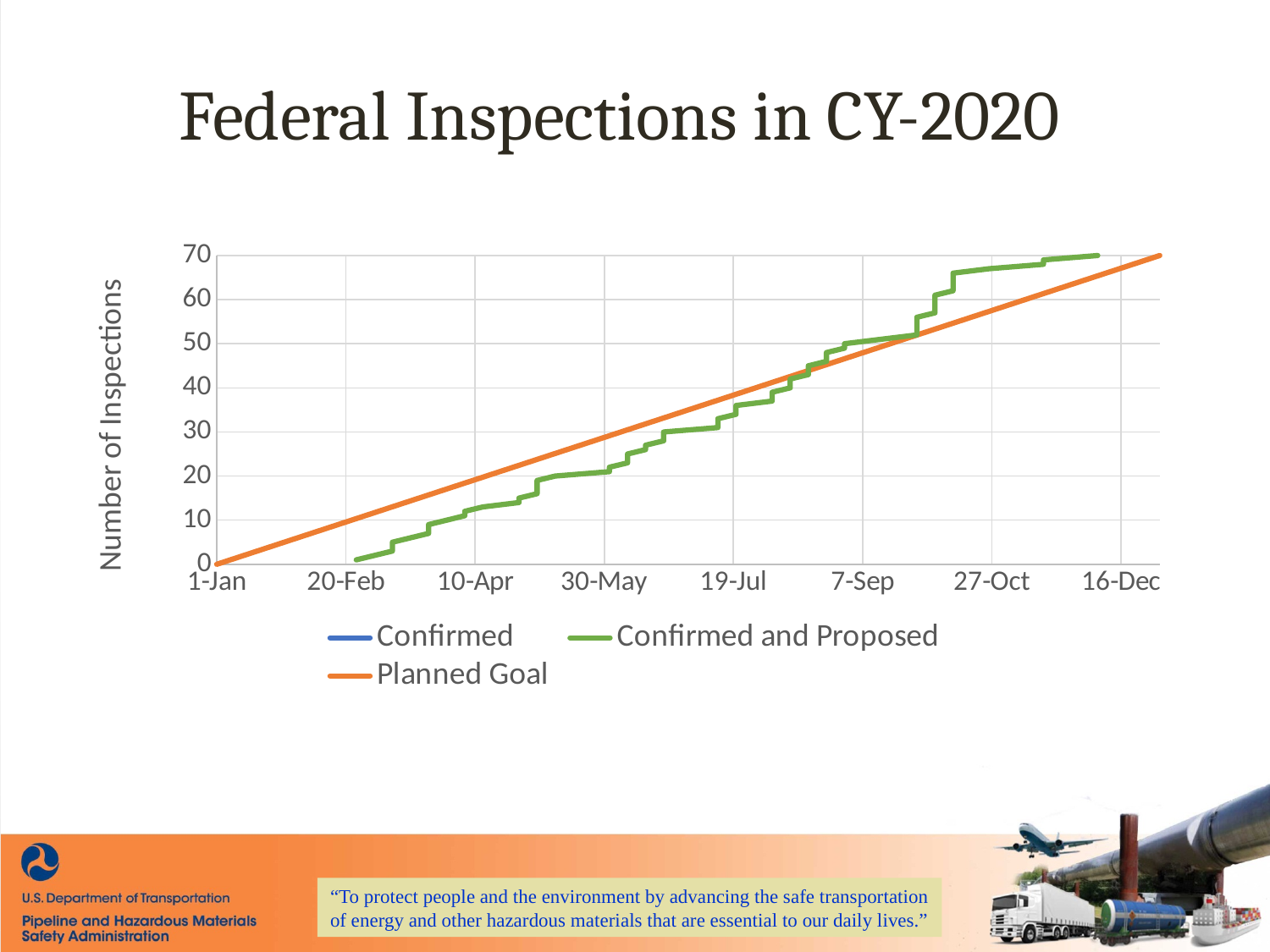
What value does the Planned Goal line reach at 16-Dec? 70 What kind of chart is shown on the slide? line chart Is the Confirmed and Proposed value at 30-May greater or less than 30? less What value does the Planned Goal line start at on 1-Jan? 0 What is the label on the vertical axis of the chart? Number of Inspections What is the title of the chart on the slide? Federal Inspections in CY-2020 Is the Planned Goal value at 19-Jul greater or less than 30? greater At 27-Oct, which line is higher: Planned Goal or Confirmed and Proposed? Confirmed and Proposed How many series does the chart legend list? 3 At 30-May, which line is higher: Planned Goal or Confirmed and Proposed? Planned Goal Does the Confirmed and Proposed line rise or fall from left to right along the x axis? rise Is the Confirmed and Proposed value at 27-Oct greater or less than 60? greater